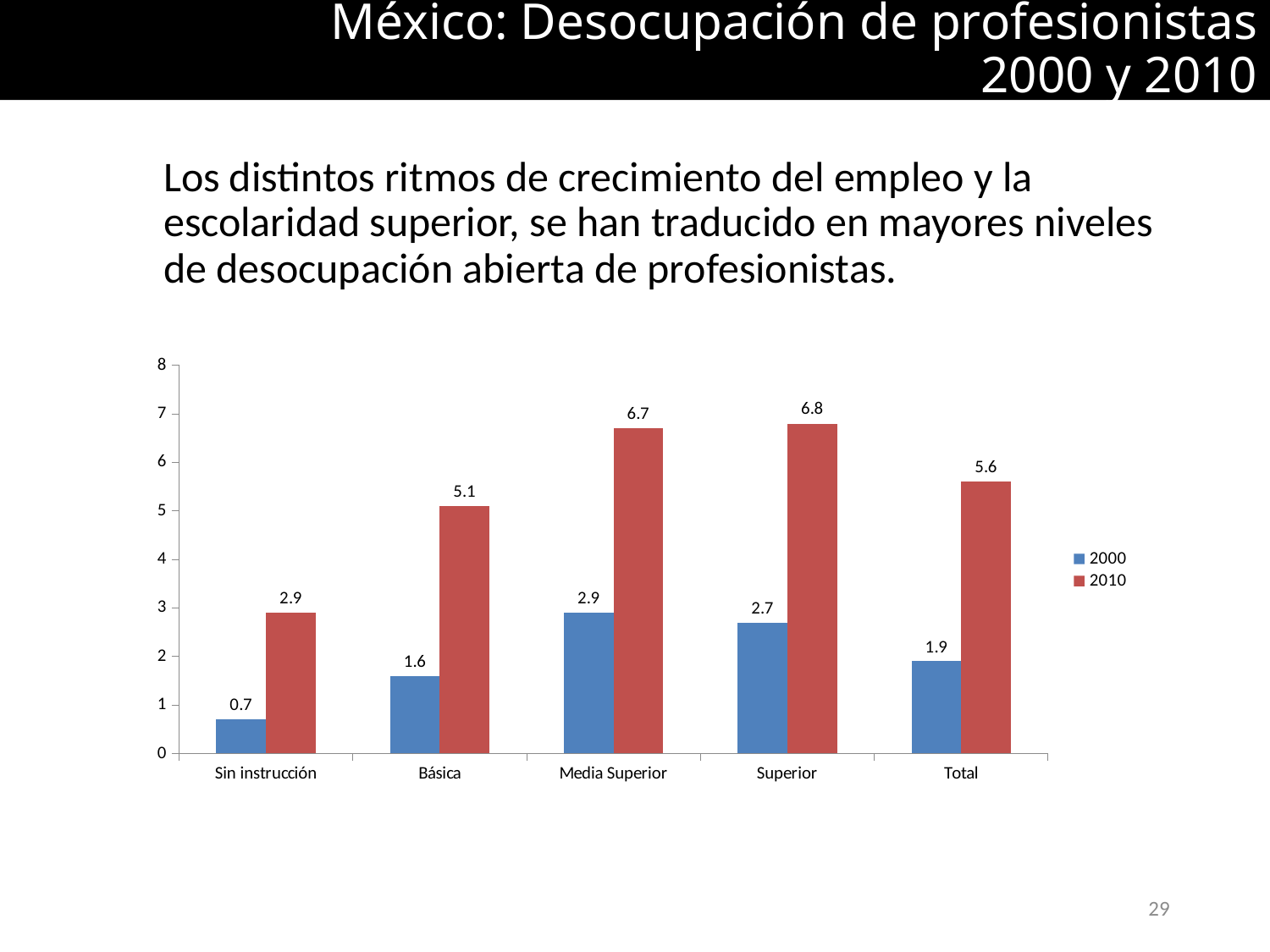
Which category has the lowest value in the 2000 series? Sin instrucción Which colour represents the 2010 series in the legend? Red Which category has the highest value in the 2010 series? Superior What kind of chart is shown on the slide? Bar chart What is the value for Superior in the 2010 series? 6.8 Which is larger: the 2000 value for Media Superior or the 2000 value for Superior? Media Superior What is the value for Básica in the 2000 series? 1.6 What is the value for Total in the 2010 series? 5.6 How many categories are shown on the x axis? 5 How many series does the legend list? 2 Is the 2010 value for Básica greater or less than 5? greater What is the difference between the 2010 and 2000 values for Media Superior? 3.8